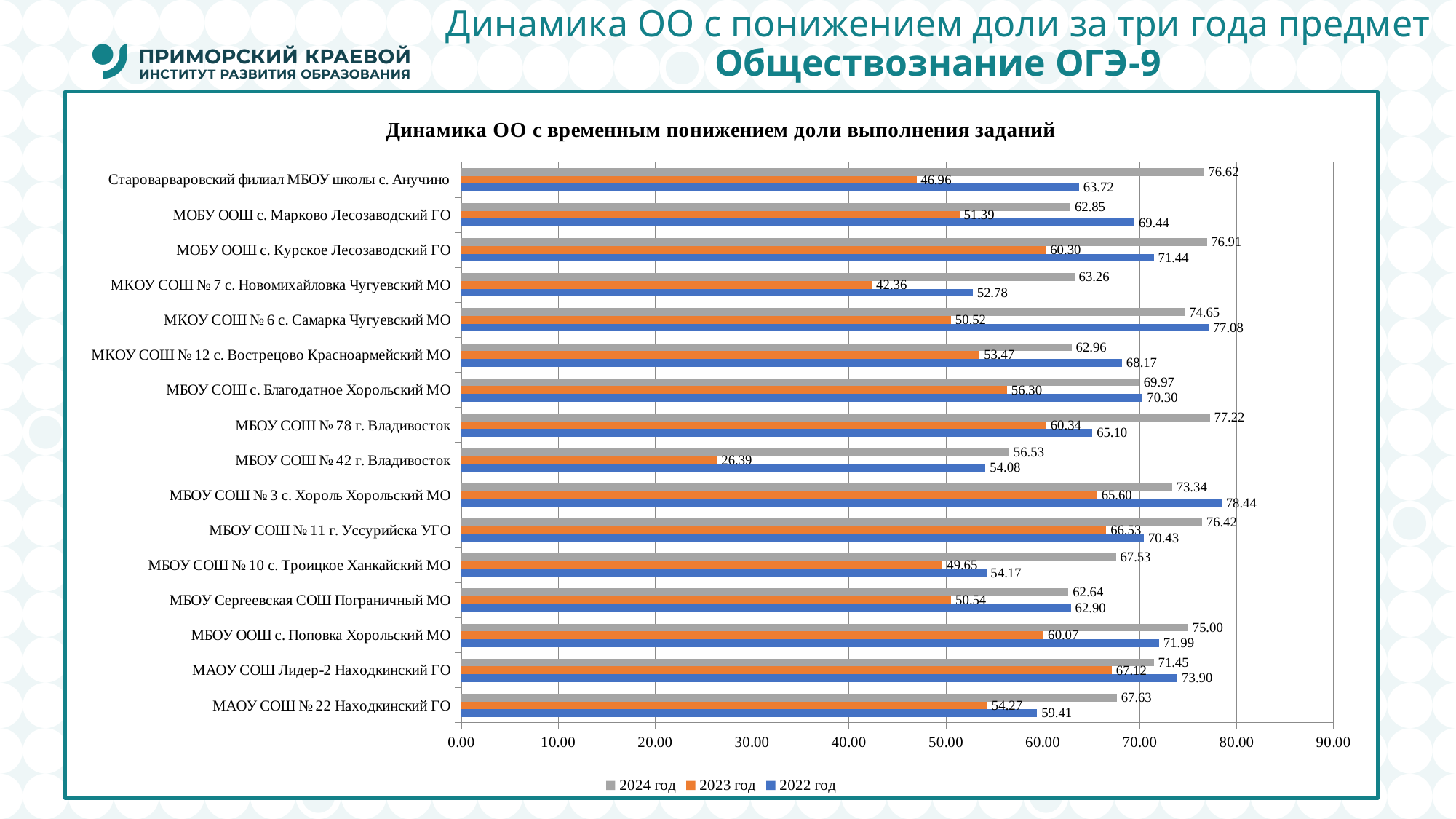
How many schools are listed on the chart? 16 What type of chart is shown on the slide? Bar chart What is the 2023 год value for МБОУ СОШ № 42 г. Владивосток? 26.39 Which school has the lowest 2023 год value? МБОУ СОШ № 42 г. Владивосток What is the difference between the 2024 год and 2023 год values for Староварваровский филиал МБОУ школы с. Анучино? 29.66 What is the 2022 год value for МКОУ СОШ № 6 с. Самарка Чугуевский МО? 77.08 Which colour represents the 2023 год series? Orange What is the 2024 год value for МБОУ ООШ с. Поповка Хорольский МО? 75.00 Which school has the highest 2024 год value? МБОУ СОШ № 78 г. Владивосток How many series does the legend list? 3 Which school has the highest 2022 год value? МБОУ СОШ № 3 с. Хороль Хорольский МО For МОБУ ООШ с. Марково Лесозаводский ГО, which is larger: the 2022 год value or the 2024 год value? 2022 год